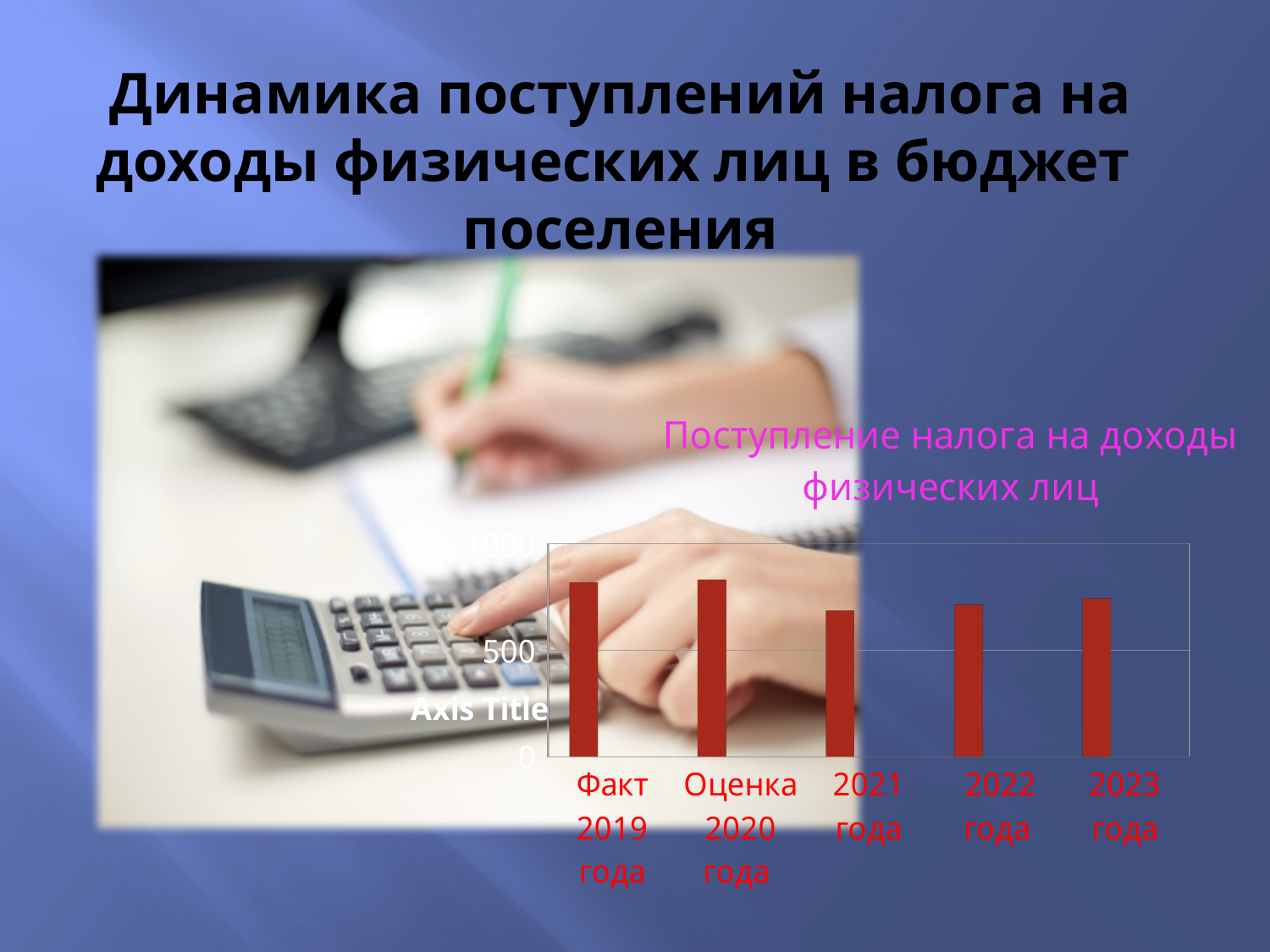
Is the value for Факт 2019 года greater or less than 500? greater Which is larger, the value for Оценка 2020 года or the value for 2021 года? Оценка 2020 года Is the value for 2022 года greater or less than 1000? less Is the value for Оценка 2020 года greater or less than 1000? less How many categories are plotted on the x axis of the chart? 5 What kind of chart is shown on the slide? bar chart What colour are the bars in the chart? red What is the title of the chart? Поступление налога на доходы физических лиц What is the highest tick value shown on the vertical axis of the chart? 1000 Which is larger, the value for Факт 2019 года or the value for 2022 года? Факт 2019 года